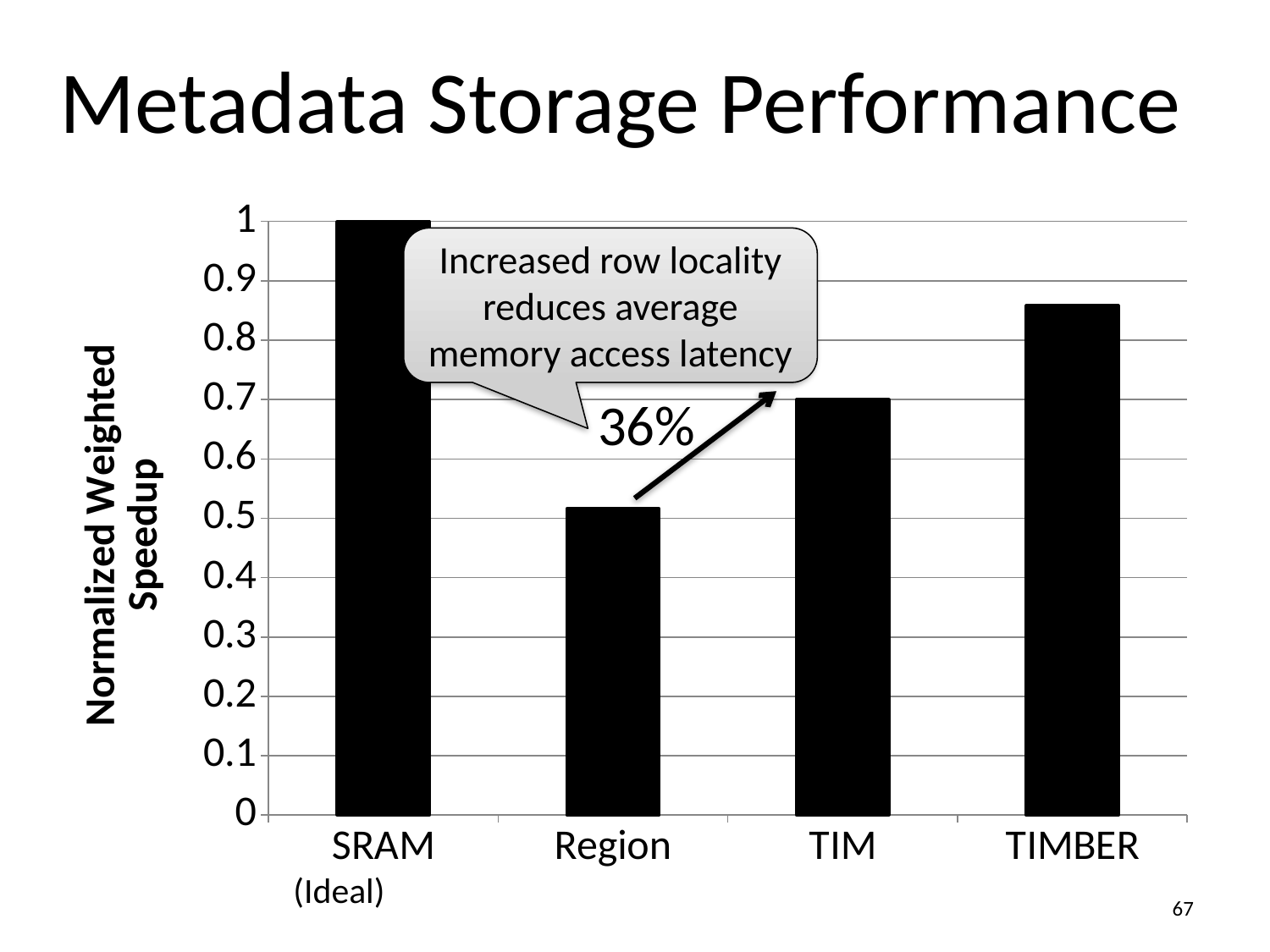
What kind of chart is shown on the slide? bar chart How many categories are plotted on the x axis? 4 Is the value for TIMBER greater or less than 0.8? greater What percentage improvement is annotated between the Region and TIM bars? 36% What is the label on the y axis? Normalized Weighted Speedup Which category has the highest normalized weighted speedup? SRAM (Ideal) Which has a higher normalized weighted speedup, Region or TIM? TIM Which category has the lowest normalized weighted speedup? Region Is the value for TIM greater or less than 0.6? greater What is the normalized weighted speedup for SRAM (Ideal)? 1 Is the value for Region greater or less than 0.6? less Which has a higher normalized weighted speedup, TIM or TIMBER? TIMBER